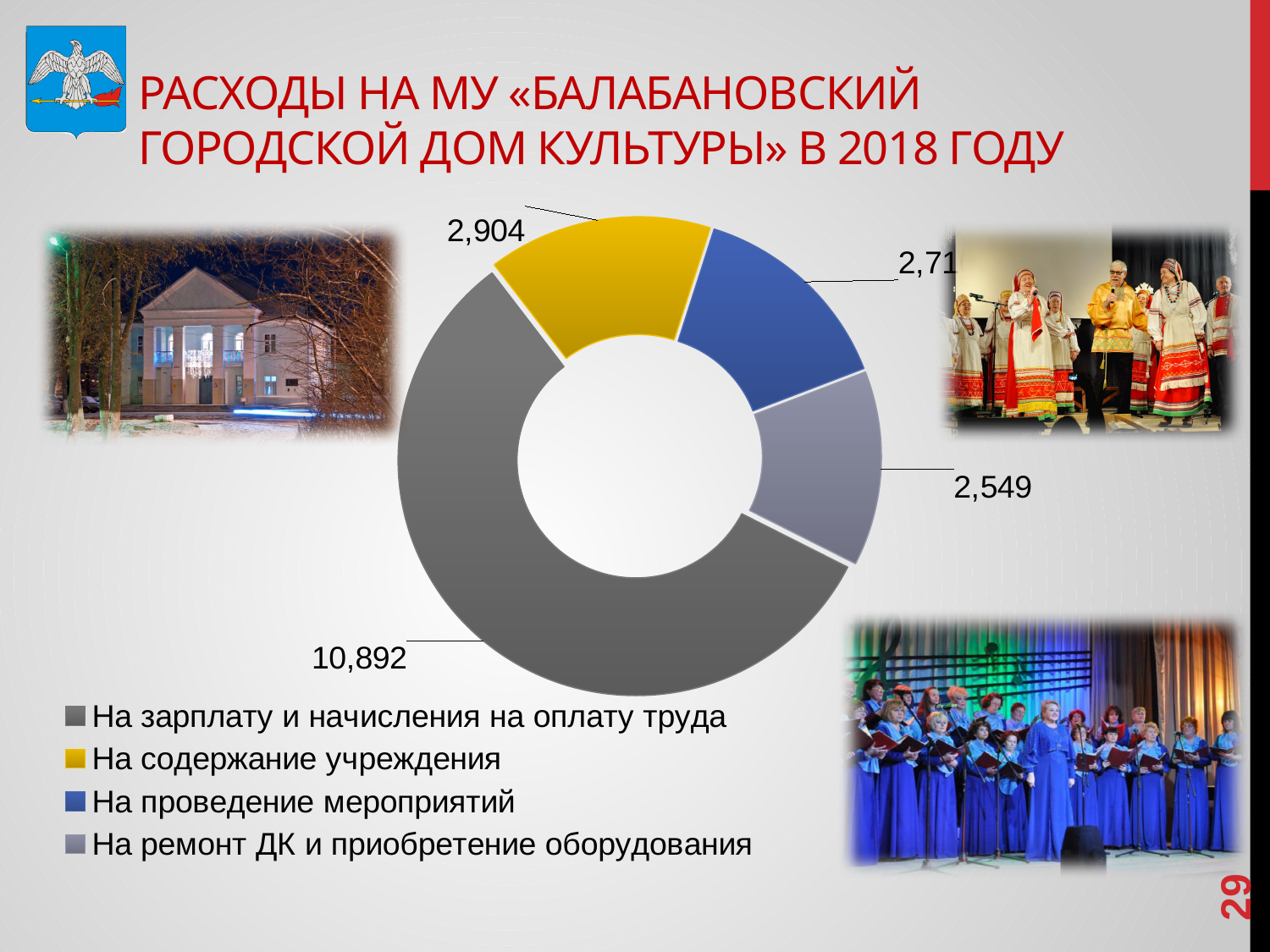
Which colour represents «На проведение мероприятий» in the chart? Blue How many categories does the chart show? 4 Which is larger: the value for «На содержание учреждения» or the value for «На ремонт ДК и приобретение оборудования»? На содержание учреждения What is the difference between the value for «На содержание учреждения» and the value for «На ремонт ДК и приобретение оборудования»? 355 What type of chart is shown on the slide? Doughnut (pie) chart What is the value for «На ремонт ДК и приобретение оборудования»? 2,549 What is the difference between the value for «На зарплату и начисления на оплату труда» and the value for «На содержание учреждения»? 7,988 Which category has the largest value? На зарплату и начисления на оплату труда How many entries does the legend list? 4 Which category has the smallest value? На ремонт ДК и приобретение оборудования What is the value for «На зарплату и начисления на оплату труда»? 10,892 What is the value for «На содержание учреждения»? 2,904